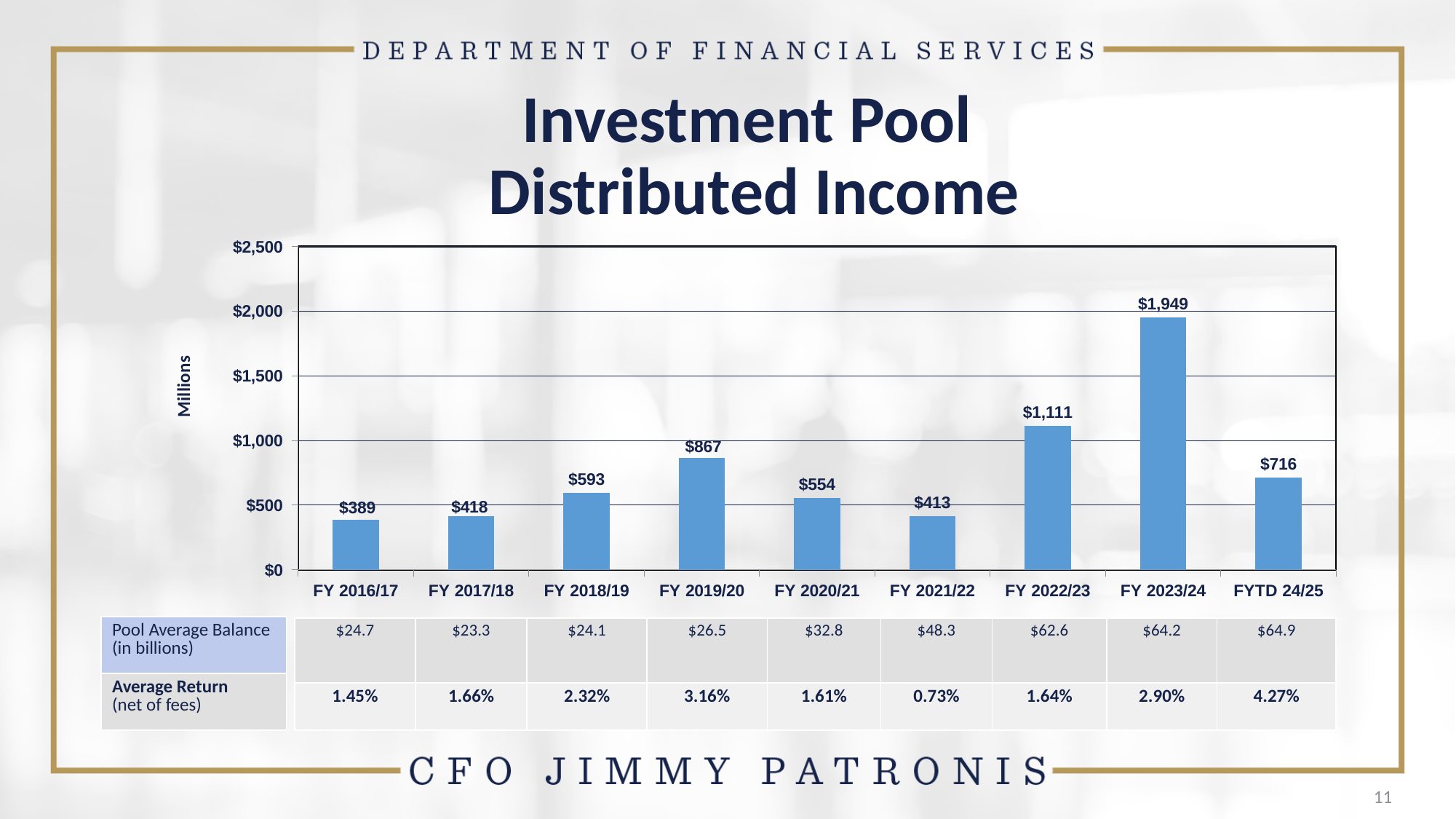
What is the difference between the distributed income for FY 2023/24 and FY 2022/23? $838 What is the distributed income value for FYTD 24/25? $716 What is the title of the chart? Investment Pool Distributed Income What is the distributed income value for FY 2023/24? $1,949 What is the distributed income value for FY 2019/20? $867 How many fiscal years are shown on the x axis of the chart? 9 Which fiscal year has the highest distributed income? FY 2023/24 Which is larger, the distributed income for FY 2018/19 or FY 2020/21? FY 2018/19 What kind of chart is shown on the slide? bar chart Does the distributed income rise or fall from FY 2021/22 to FY 2023/24? rise Is the distributed income for FY 2022/23 greater or less than $1,000? greater Which fiscal year has the lowest distributed income? FY 2016/17